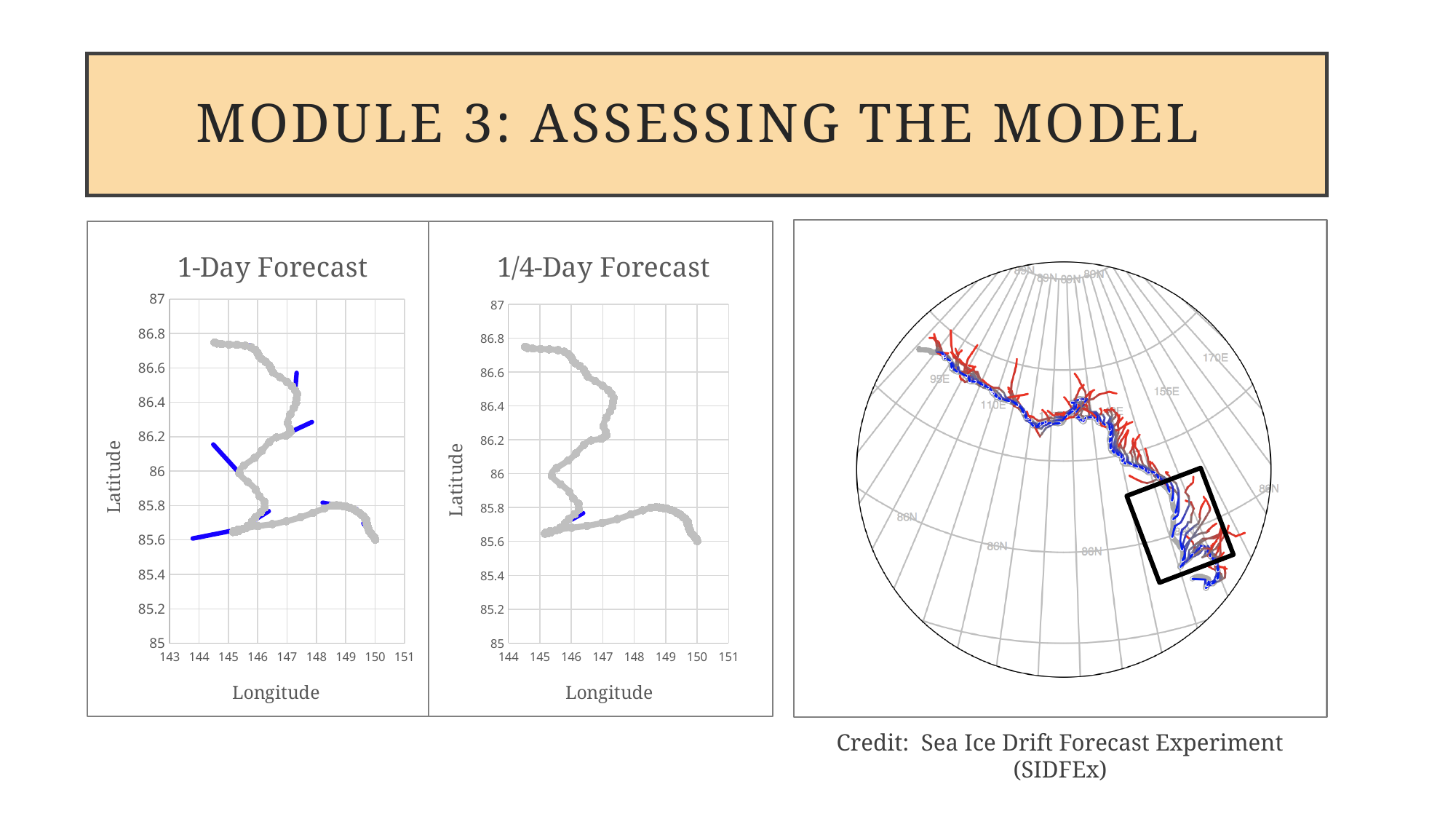
In the "1-Day Forecast" chart, what is the lowest value shown on the horizontal axis? 143 In the "1-Day Forecast" chart, what is the label of the vertical axis? Latitude What is the title of the middle chart on the slide? 1/4-Day Forecast In the "1/4-Day Forecast" chart, what is the label of the horizontal axis? Longitude In the "1-Day Forecast" chart, what is the highest value shown on the vertical axis? 87 In the "1/4-Day Forecast" chart, is the latitude of the lowest point of the gray track greater or less than 85.8? less In the "1-Day Forecast" chart, is the latitude of the highest point of the gray track greater or less than 86.6? greater In the "1/4-Day Forecast" chart, what is the lowest value shown on the horizontal axis? 144 What kind of chart is the "1-Day Forecast" chart? Scatter chart In the "1-Day Forecast" chart, is the longitude of the right-most end of the gray track greater or less than 149? greater How many scatter charts with Latitude and Longitude axes are shown on the slide? 2 What is the title of the left-hand chart on the slide? 1-Day Forecast